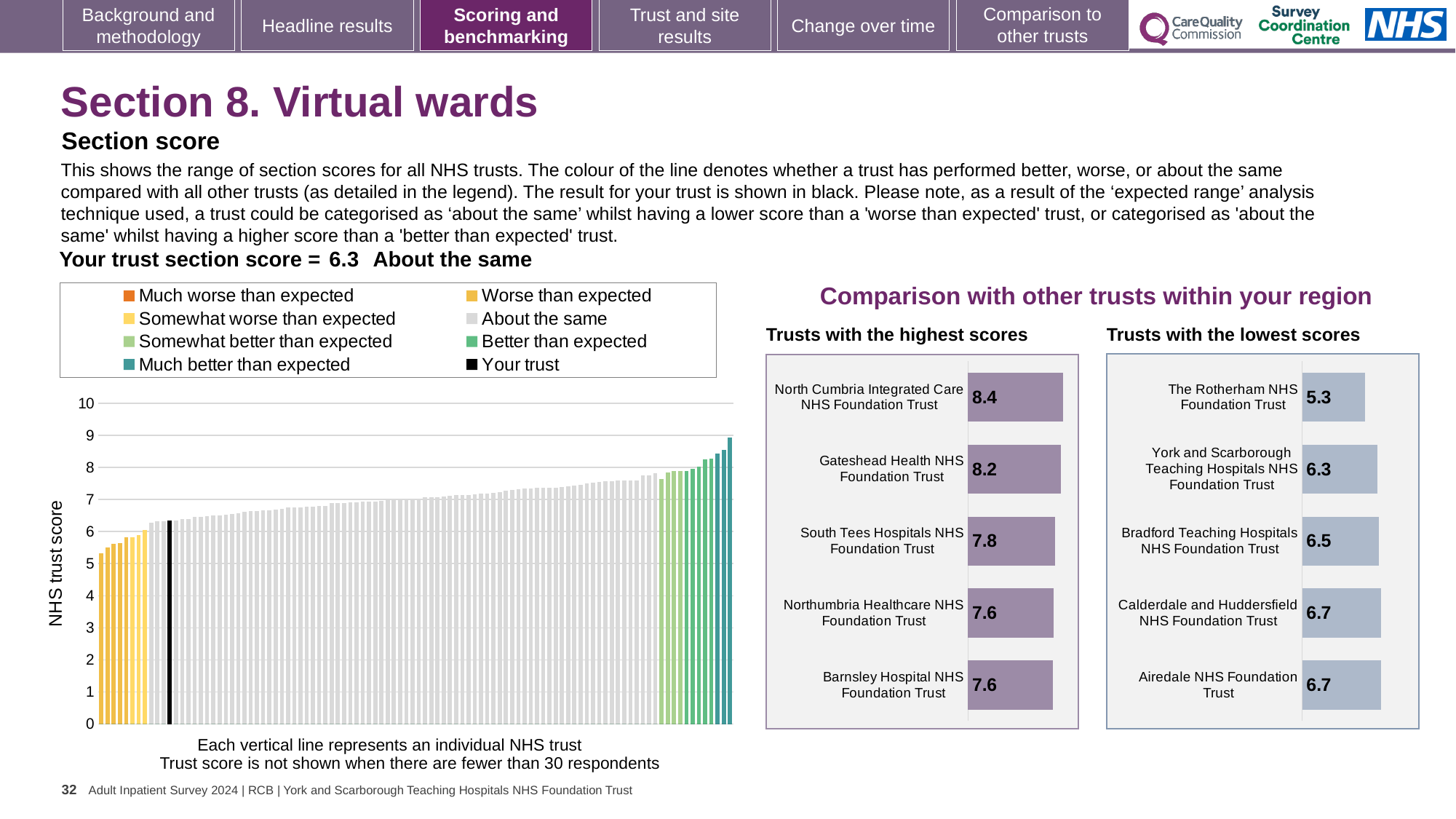
In the 'Trusts with the lowest scores' chart, which trust has the lowest score? The Rotherham NHS Foundation Trust In the 'Trusts with the highest scores' chart, which trust has the highest score? North Cumbria Integrated Care NHS Foundation Trust In the 'Trusts with the highest scores' chart, which has the larger score: Gateshead Health NHS Foundation Trust or South Tees Hospitals NHS Foundation Trust? Gateshead Health NHS Foundation Trust In the 'Trusts with the highest scores' chart, what is the difference between the scores of North Cumbria Integrated Care NHS Foundation Trust and South Tees Hospitals NHS Foundation Trust? 0.6 In the 'Trusts with the lowest scores' chart, what is the score for Airedale NHS Foundation Trust? 6.7 In the NHS trust score chart on the left, what is the section score for your trust (the black bar)? 6.3 In the 'Trusts with the lowest scores' chart, what is the difference between the scores of Bradford Teaching Hospitals NHS Foundation Trust and The Rotherham NHS Foundation Trust? 1.2 In the 'Trusts with the lowest scores' chart, what is the score for Bradford Teaching Hospitals NHS Foundation Trust? 6.5 In the 'Trusts with the highest scores' chart, what is the score for North Cumbria Integrated Care NHS Foundation Trust? 8.4 In the NHS trust score chart on the left, how many entries does the legend list? 8 In the 'Trusts with the highest scores' chart, how many trusts are shown? 5 In the NHS trust score chart on the left, do the trust scores rise or fall from left to right? rise